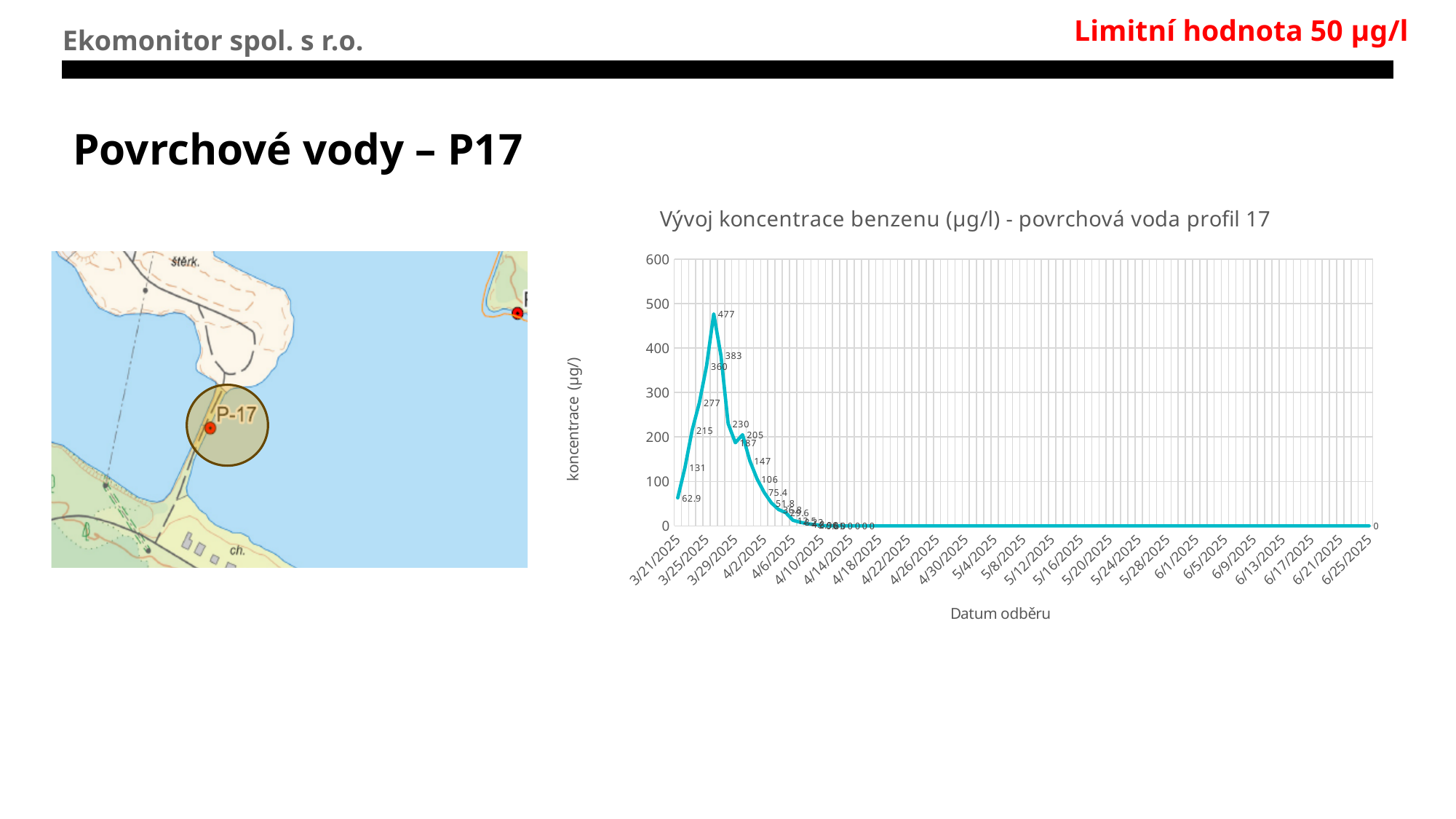
Is the value on 5/4/2025 greater or less than 100? less What is the label of the x axis of the chart? Datum odběru What is the difference between the peak value 477 and the value labelled immediately after it, 383? 94 What is the highest tick value shown on the y axis? 600 What kind of chart is shown on the slide? line chart What is the title of the chart? Vývoj koncentrace benzenu (µg/l) - povrchová voda profil 17 Which is larger, the value labelled 360 just before the peak or the value labelled 383 just after the peak? 383 What is the value labelled at the first point of the line, on 3/21/2025? 62.9 What is the difference between the peak value 477 and the first value 62.9? 414.1 After reaching its peak, does the line generally rise or fall along the x axis? fall What is the highest value labelled on the line in the chart? 477 What is the value labelled at the last point of the line, on 6/25/2025? 0